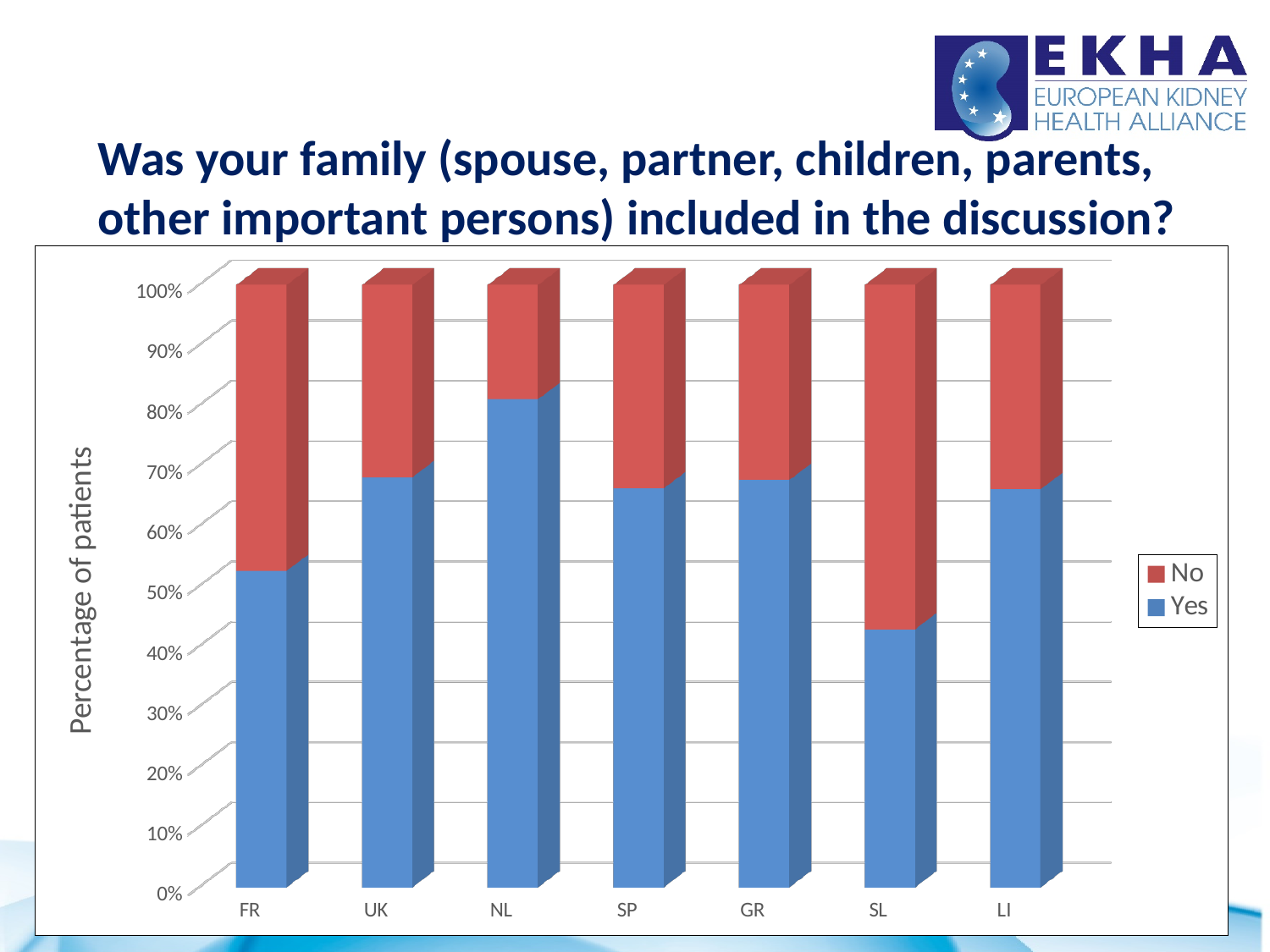
What kind of chart is shown on the slide? Stacked bar chart How many series does the legend list? 2 Is the 'Yes' value for NL greater or less than 70%? greater What is the label of the y axis? Percentage of patients What is the total height of the stacked bar for FR? 100% Which country has a larger 'Yes' share, FR or UK? UK Is the 'Yes' value for UK greater or less than 60%? greater Which country has the lowest share of 'Yes' responses? SL Which country has the highest share of 'Yes' responses? NL Is the 'Yes' value for SL greater or less than 50%? less How many countries are shown on the x axis of the chart? 7